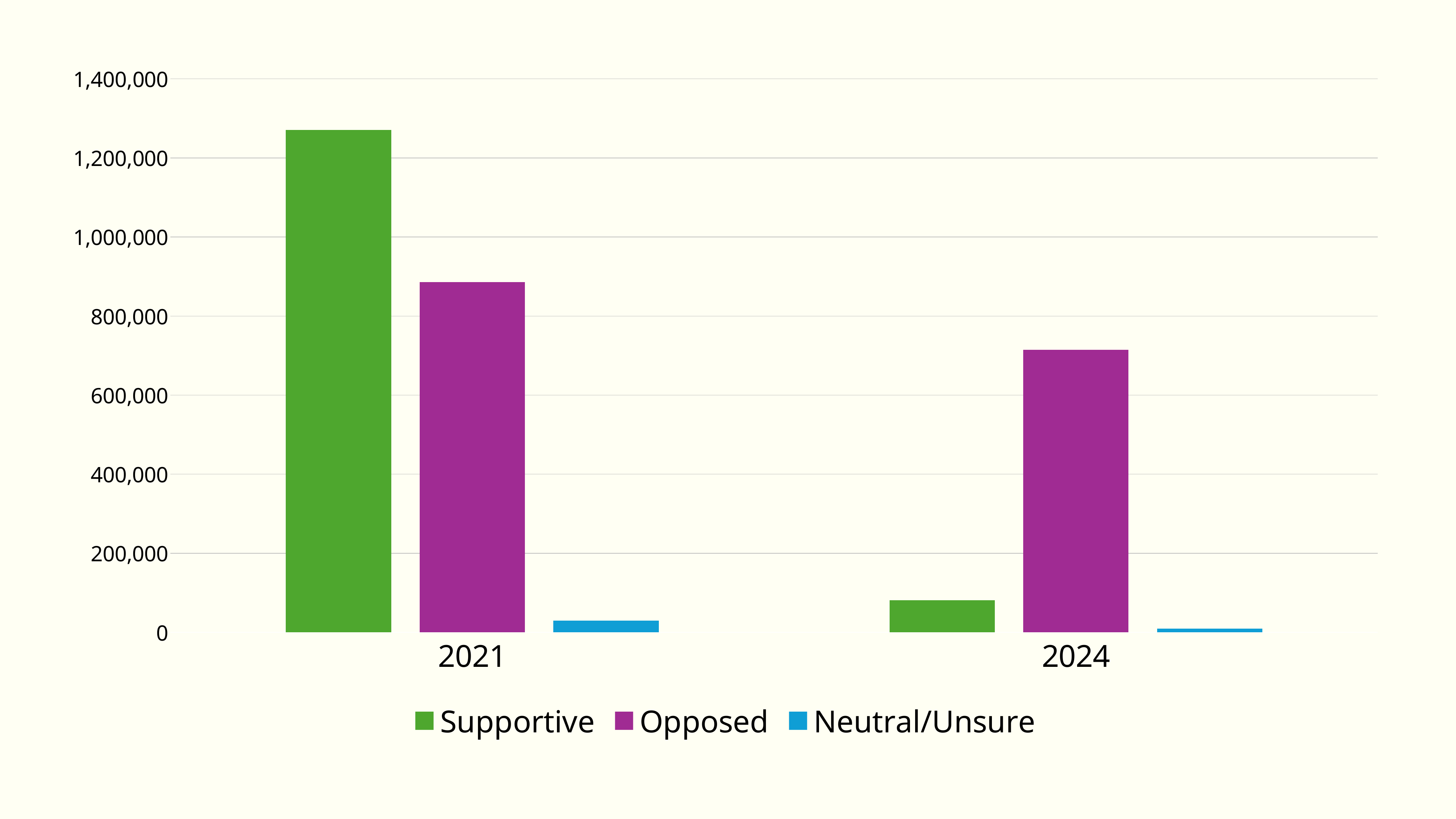
Which series has the highest value in 2021? Supportive How many series does the legend list? 3 What kind of chart is shown on the slide? bar chart Which series has the highest value in 2024? Opposed Is the value for Opposed in 2024 greater or less than 800,000? less Is the value for Supportive in 2021 greater or less than 1,200,000? greater Which is larger, Opposed in 2021 or Opposed in 2024? Opposed in 2021 What colour represents the Neutral/Unsure series? blue How many categories are shown on the x axis? 2 Which series has the lowest value in 2024? Neutral/Unsure Is the value for Supportive in 2024 greater or less than 200,000? less Does the Supportive series rise or fall from 2021 to 2024? fall